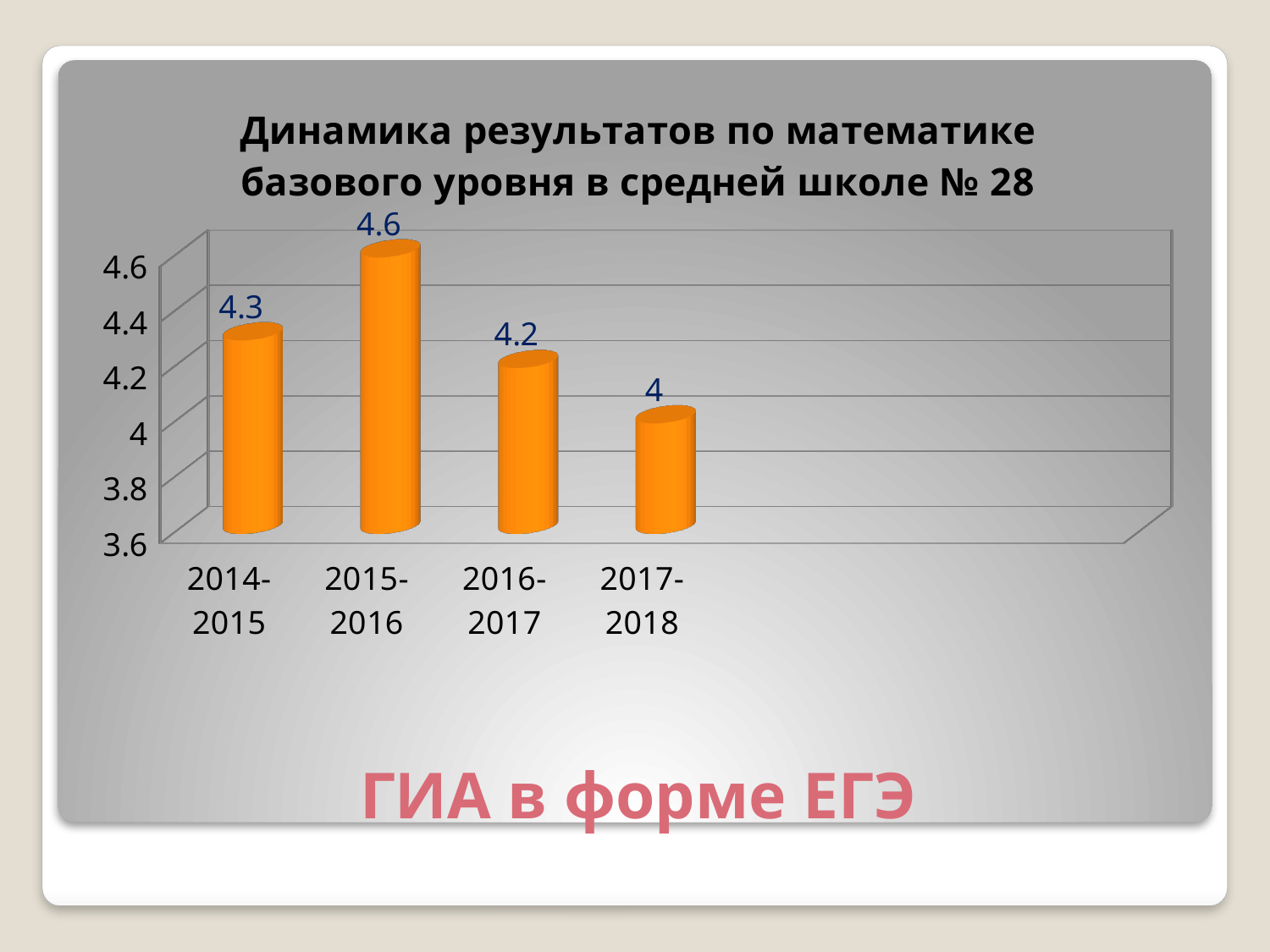
What is the value for 2015-2016? 4.6 How many school years are shown on the chart? 4 What is the value for 2017-2018? 4 What is the difference between the values for 2015-2016 and 2017-2018? 0.6 Which school year has the lowest value? 2017-2018 What is the value for 2014-2015? 4.3 Which is larger, the value for 2014-2015 or the value for 2016-2017? 2014-2015 Is the value for 2015-2016 greater or less than 4.4? greater Which school year has the highest value? 2015-2016 What is the title of the chart? Динамика результатов по математике базового уровня в средней школе № 28 What is the value for 2016-2017? 4.2 What kind of chart is shown on the slide? bar chart